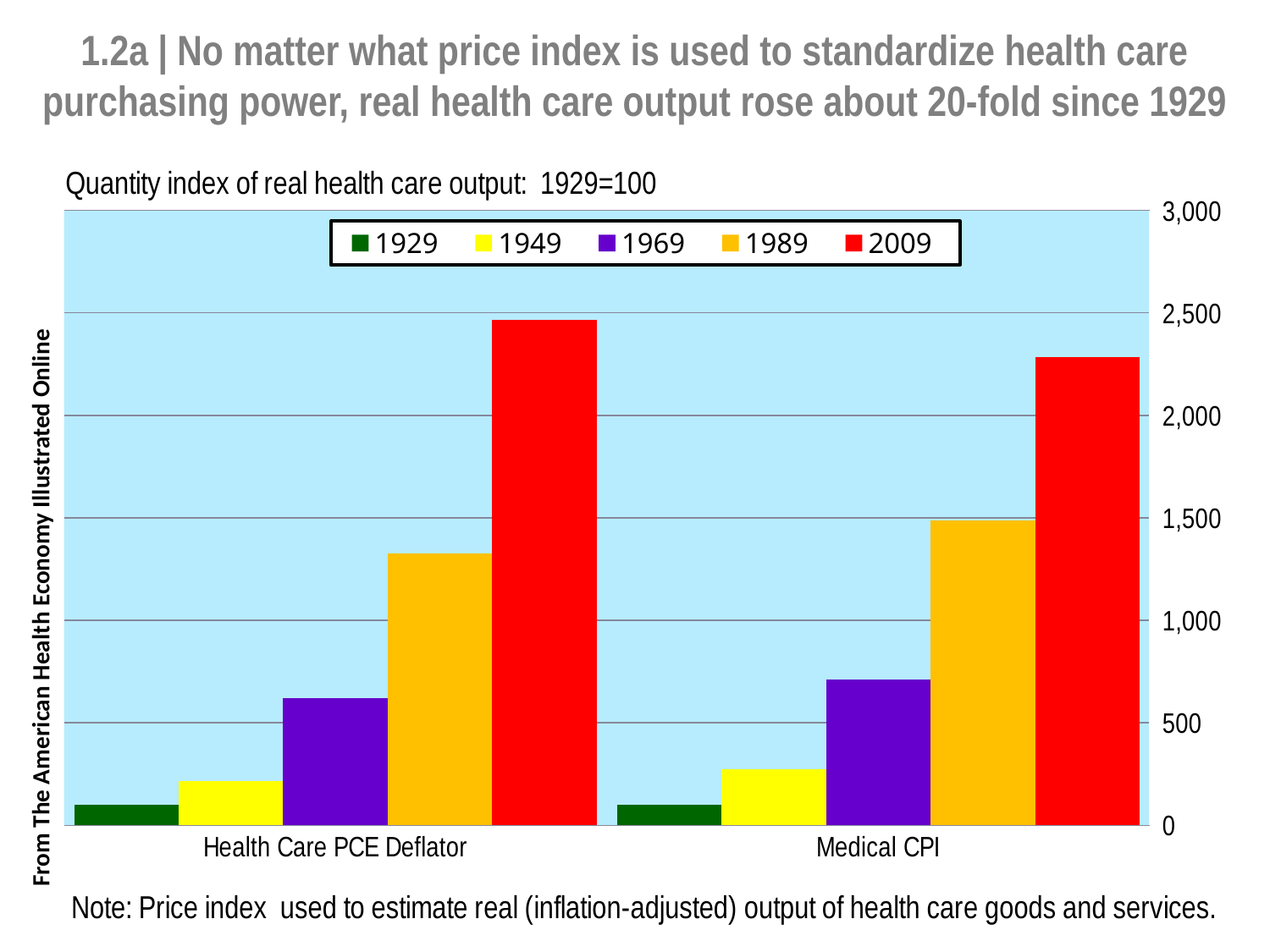
Which year has the highest value for Health Care PCE Deflator? 2009 Is the 2009 value for Health Care PCE Deflator greater or less than 2,000? greater How many categories are shown on the x axis? 2 Do the values for Medical CPI rise or fall from 1929 to 2009? rise What base year and value is the quantity index set to, according to the chart subtitle? 1929=100 Is the 1989 value for Health Care PCE Deflator greater or less than 1,000? greater Which year has the lowest value for Medical CPI? 1929 Is the 2009 value for Medical CPI greater or less than 2,500? less What kind of chart is shown on the slide? bar chart Which is larger, the 2009 value for Health Care PCE Deflator or the 2009 value for Medical CPI? Health Care PCE Deflator How many series does the legend list? 5